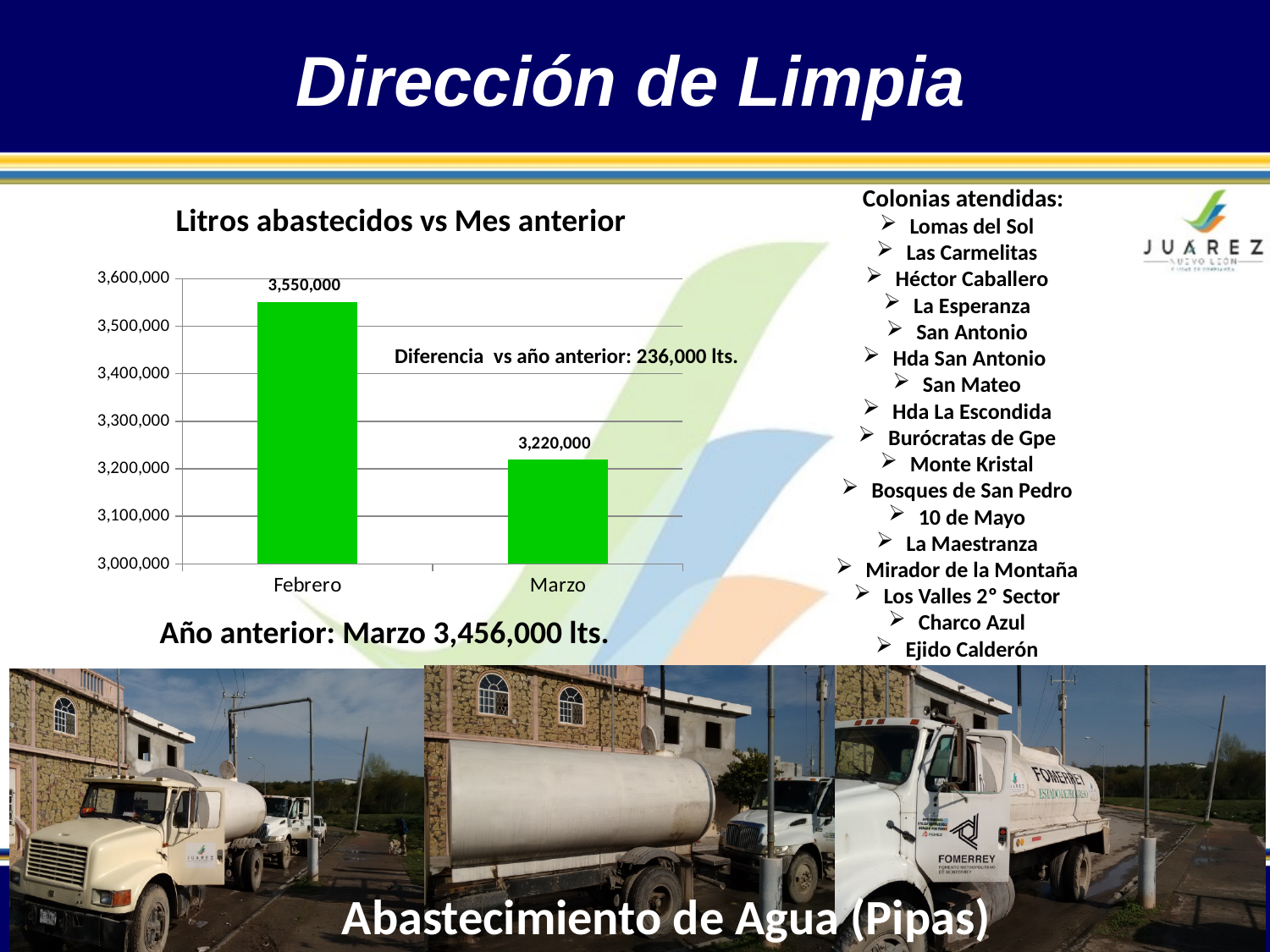
Is the value for Febrero greater or less than 3,500,000? greater What is the value for Marzo in the chart? 3,220,000 What is the difference between the Febrero and Marzo values? 330,000 Do the values rise or fall from Febrero to Marzo? fall What is the value for Febrero in the chart? 3,550,000 Is the value for Marzo greater or less than 3,300,000? less How many categories are shown on the x axis of the chart? 2 Which month has the lower value in the chart? Marzo What is the title of the chart? Litros abastecidos vs Mes anterior What colour are the bars in the chart? green What kind of chart is shown on the slide? bar chart Which month has the higher value in the chart? Febrero